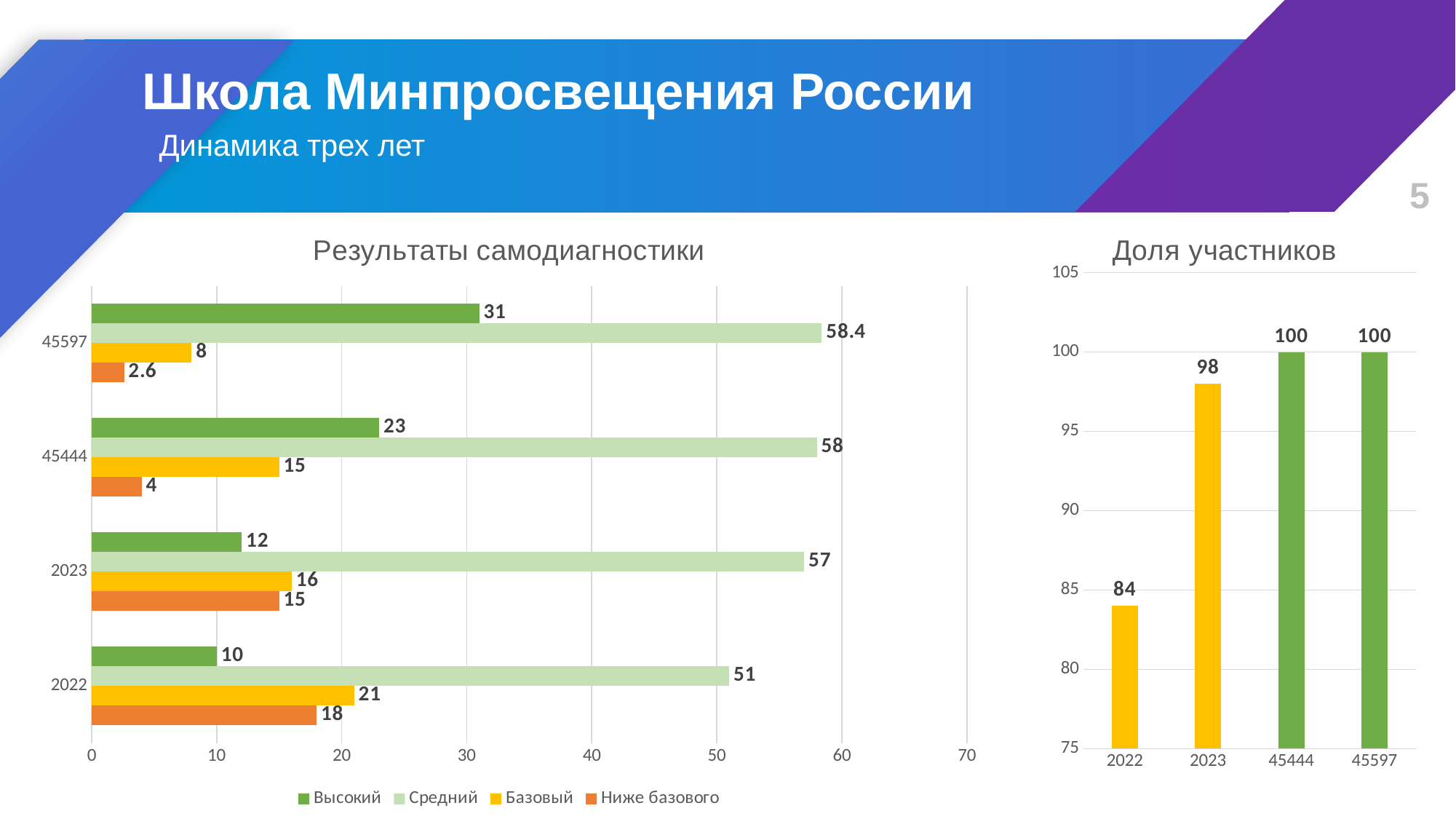
In the chart "Доля участников", what is the value for 2023? 98 In the chart "Результаты самодиагностики", how many series does the legend list? 4 In the chart "Результаты самодиагностики", which category has the highest "Высокий" value? 45597 In the chart "Результаты самодиагностики", what is the value of "Высокий" for category 45444? 23 In the chart "Результаты самодиагностики", is the "Высокий" value for 2023 larger or smaller than the "Базовый" value for 2023? smaller What kind of chart is "Доля участников"? bar chart In the chart "Результаты самодиагностики", which category has the lowest "Ниже базового" value? 45597 In the chart "Доля участников", what is the difference between the values for 2023 and 2022? 14 In the chart "Доля участников", which category has the lowest value? 2022 In the chart "Результаты самодиагностики", what is the value of "Средний" for category 45597? 58.4 In the chart "Результаты самодиагностики", what is the value of "Ниже базового" for 2022? 18 In the chart "Результаты самодиагностики", what is the difference between the "Базовый" values for 2022 and 2023? 5